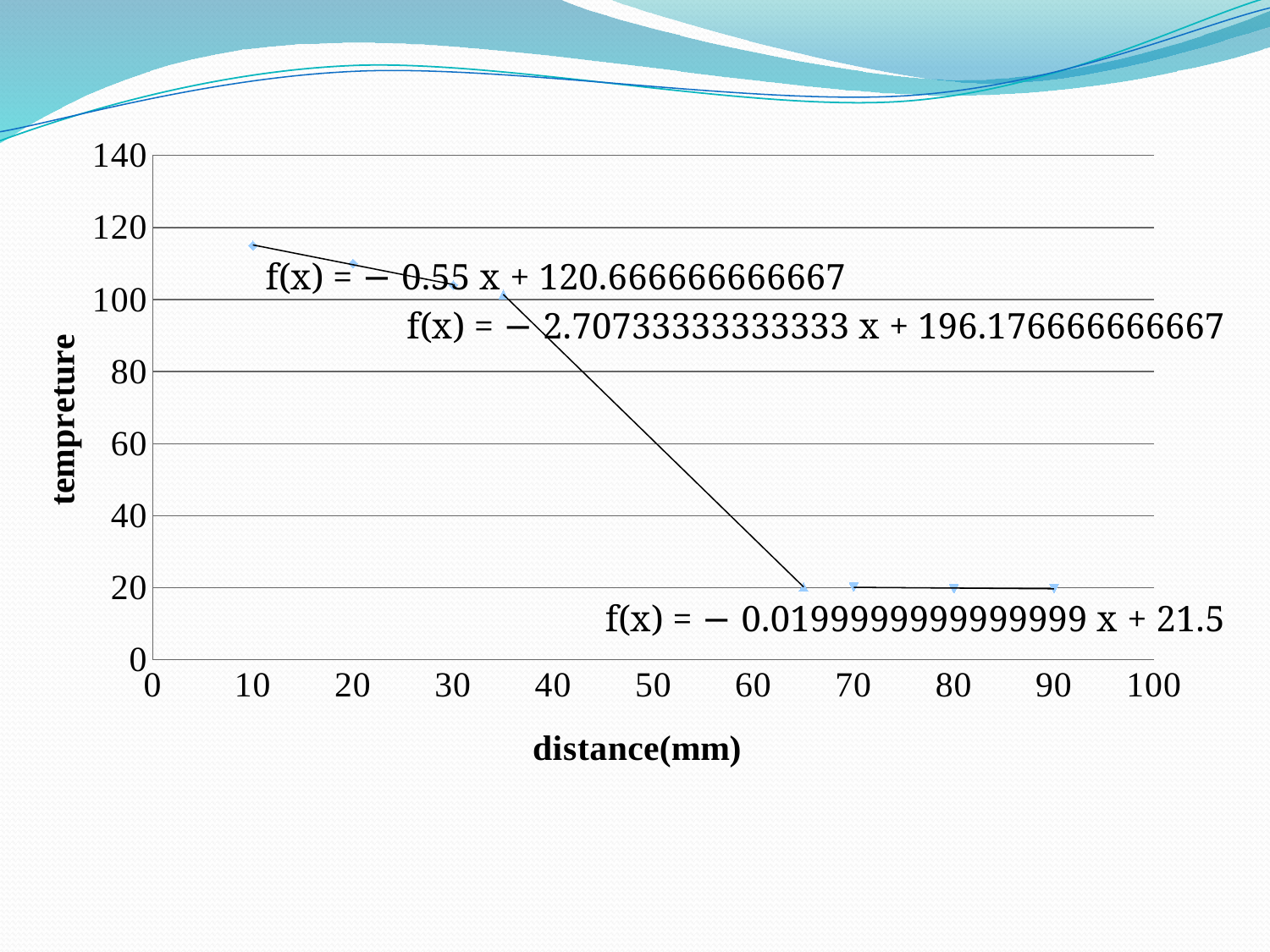
Is the temperature value at a distance of 20 mm greater or less than 100? greater What kind of chart is shown on the slide? scatter chart with trendlines What is the title of the x axis? distance(mm) Which has the lower temperature value: the point at 30 mm or the point at 80 mm? 80 mm Do the temperature values rise or fall as distance increases along the x axis? fall Is the temperature value at a distance of 90 mm greater or less than 40? less Is the temperature value at a distance of 10 mm greater or less than 100? greater Which has the higher temperature value: the point at 10 mm or the point at 70 mm? 10 mm At which plotted distance is the temperature highest? 10 mm What is the title of the y axis? tempreture What is the maximum value shown on the y axis? 140